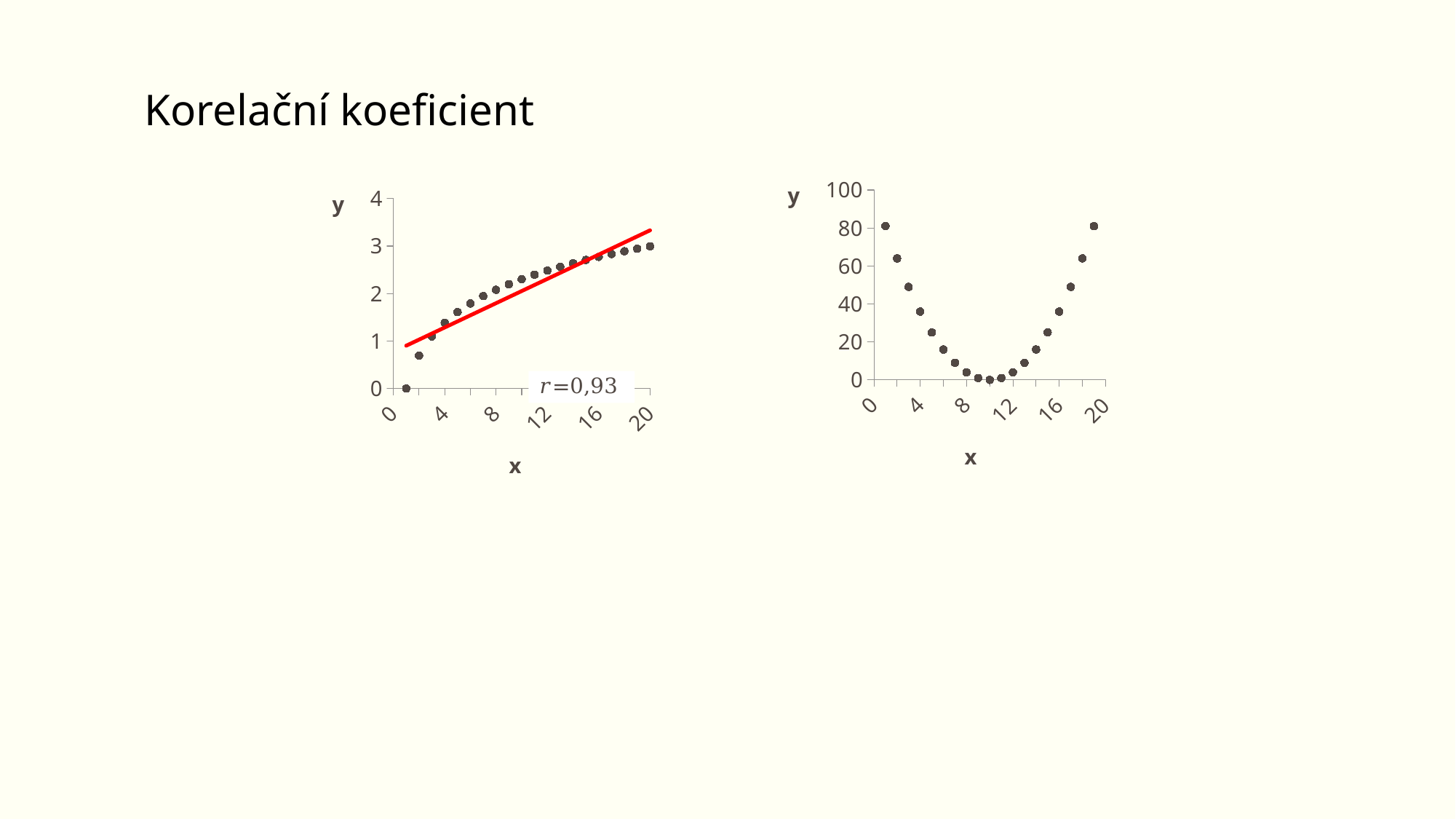
What kind of chart is the chart on the left? scatter chart In the chart on the right, is the value for x = 1 greater or less than 60? greater In the chart on the right, is the value for x = 10 greater or less than 20? less What kind of chart is the chart on the right? scatter chart In the chart on the left, what correlation coefficient r is shown? r=0,93 In the chart on the left, what colour is the fitted trend line? red In the chart on the left, is the value for x = 20 greater or less than 2? greater In the chart on the right, which has the larger y value, x = 4 or x = 8? x = 4 In the chart on the right, at which x value is y lowest? 10 In the chart on the right, do the y values rise or fall as x increases from 0 to 10? fall In the chart on the left, do the y values rise or fall as x increases? rise